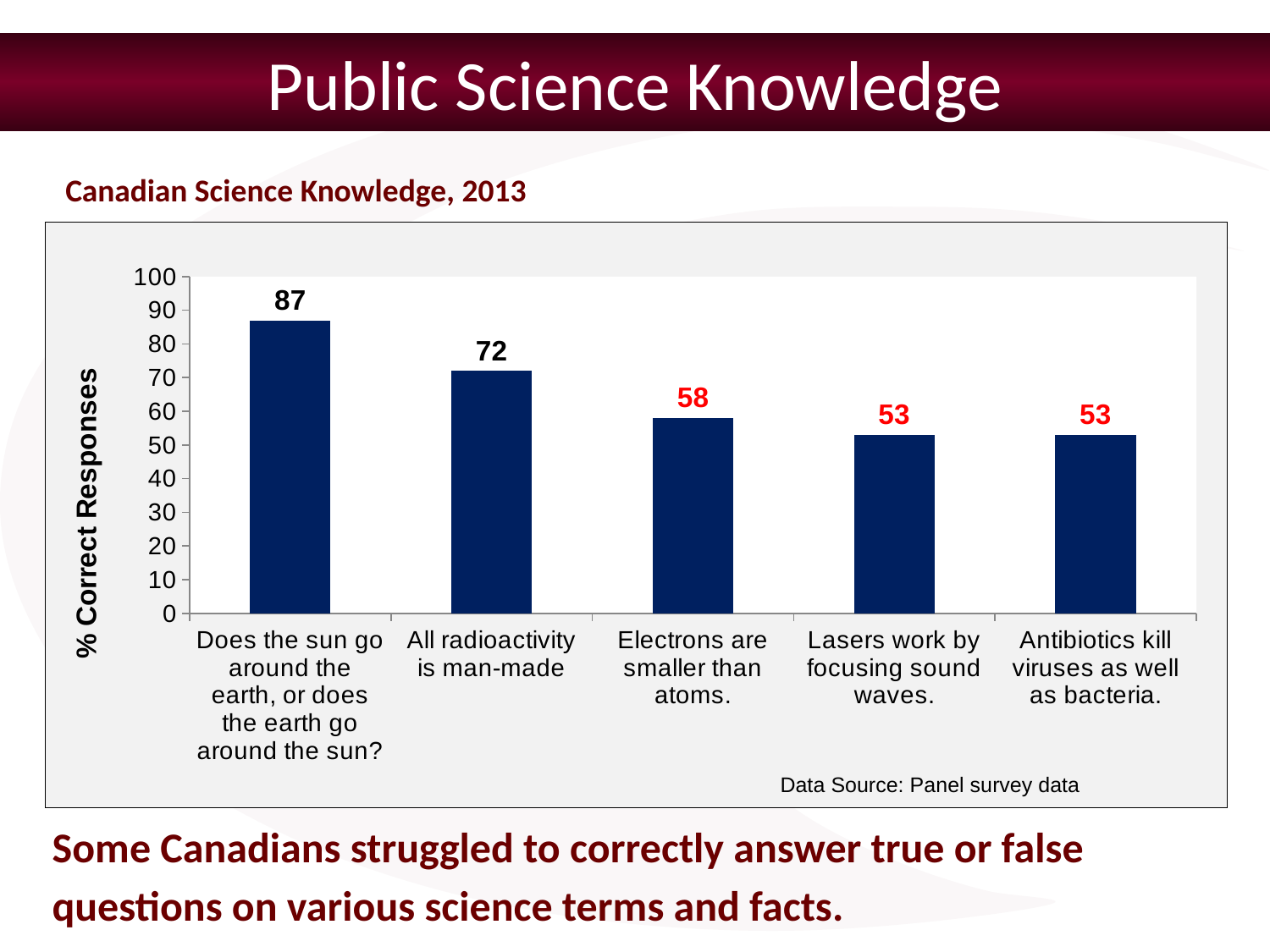
Which category has the highest percentage of correct responses? Does the sun go around the earth, or does the earth go around the sun? What is the difference between the values for "Does the sun go around the earth, or does the earth go around the sun?" and "All radioactivity is man-made"? 15 What is the value for "Lasers work by focusing sound waves."? 53 Which is larger: the value for "All radioactivity is man-made" or the value for "Electrons are smaller than atoms."? All radioactivity is man-made What is the value for "Electrons are smaller than atoms."? 58 Is the value for "Does the sun go around the earth, or does the earth go around the sun?" greater or less than 80? greater What is the difference between the values for "Electrons are smaller than atoms." and "Antibiotics kill viruses as well as bacteria."? 5 Do the values rise or fall from left to right along the x axis? Fall What kind of chart is shown on the slide? Bar chart How many categories are shown in the chart? 5 What is the label of the vertical axis? % Correct Responses What is the value for "All radioactivity is man-made"? 72